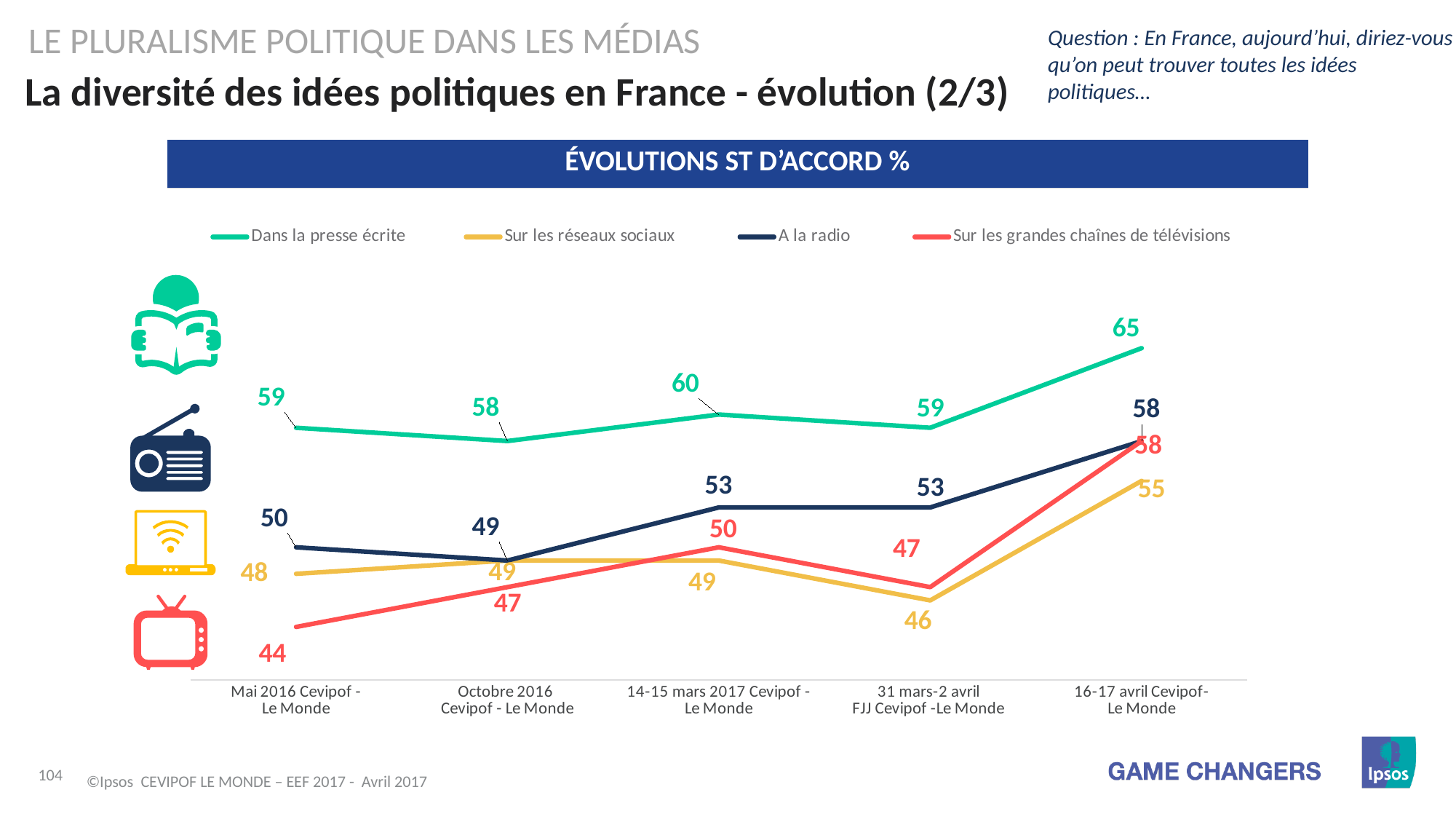
What type of chart is shown on the slide? line chart How many series does the legend list? 4 What is the value for 'Dans la presse écrite' at 16-17 avril Cevipof - Le Monde? 65 What is the value for 'A la radio' at 14-15 mars 2017 Cevipof - Le Monde? 53 At Octobre 2016 Cevipof - Le Monde, which is larger: 'A la radio' or 'Sur les grandes chaînes de télévisions'? A la radio Which series has the lowest value at Mai 2016 Cevipof - Le Monde? Sur les grandes chaînes de télévisions Which series has the highest value at 16-17 avril Cevipof - Le Monde? Dans la presse écrite How many time points are plotted along the x axis? 5 What is the value for 'Sur les réseaux sociaux' at 31 mars-2 avril FJJ Cevipof - Le Monde? 46 What is the title shown in the blue banner above the chart? ÉVOLUTIONS ST D'ACCORD % What is the difference between the 'Sur les grandes chaînes de télévisions' values at 16-17 avril Cevipof - Le Monde and Mai 2016 Cevipof - Le Monde? 14 What is the value for 'Sur les grandes chaînes de télévisions' at Mai 2016 Cevipof - Le Monde? 44